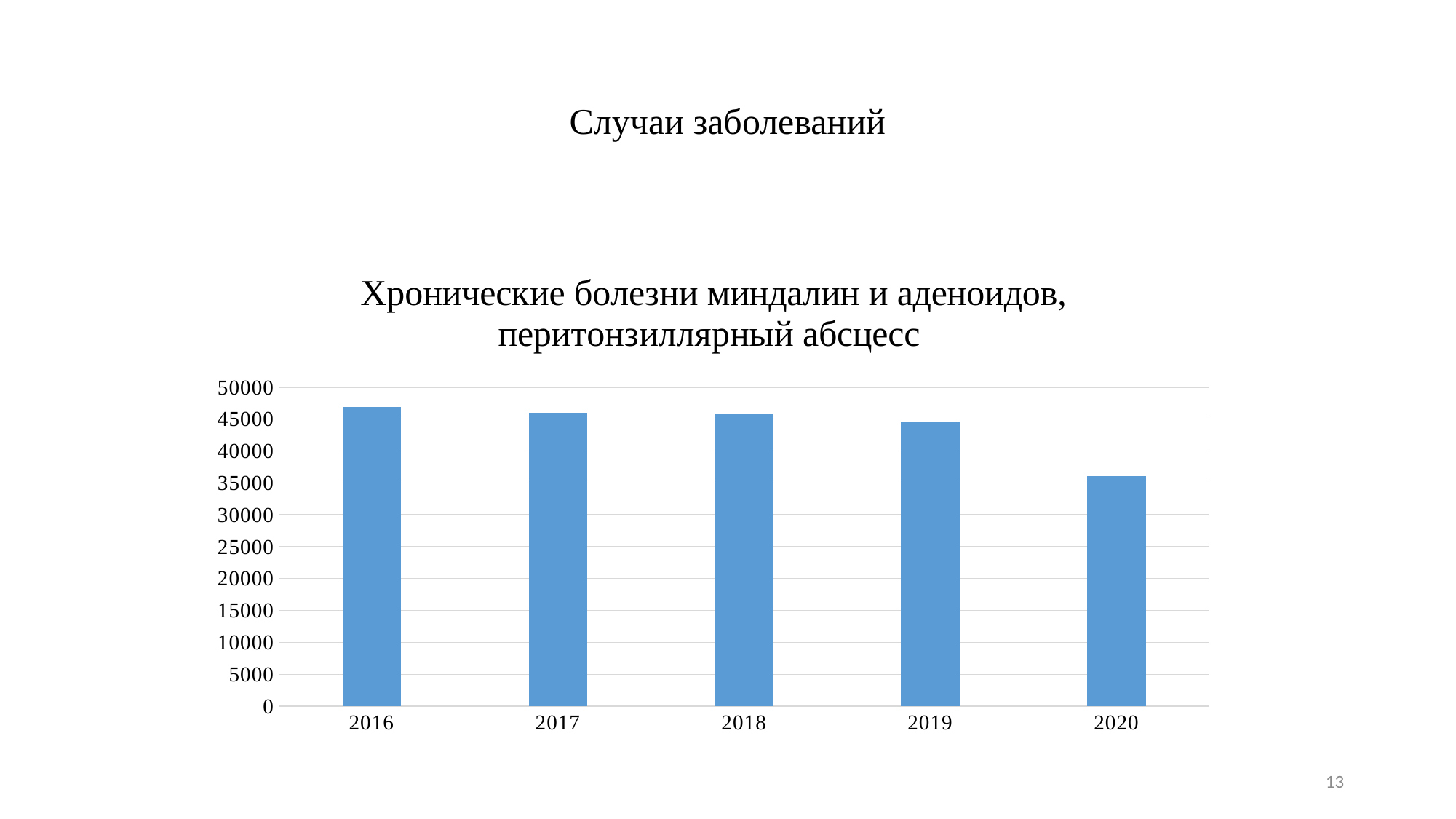
How many years are shown on the x axis of the chart? 5 Which year has the lowest number of cases in the chart? 2020 Is the value for 2016 greater or less than 45000? greater What is the title of the chart? Хронические болезни миндалин и аденоидов, перитонзиллярный абсцесс Which is larger, the value for 2019 or the value for 2020? 2019 Is the value for 2019 greater or less than 40000? greater Is the value for 2018 greater or less than 50000? less Do the values rise or fall from 2016 to 2020? fall Which is larger, the value for 2016 or the value for 2020? 2016 What kind of chart is shown on the slide? bar chart